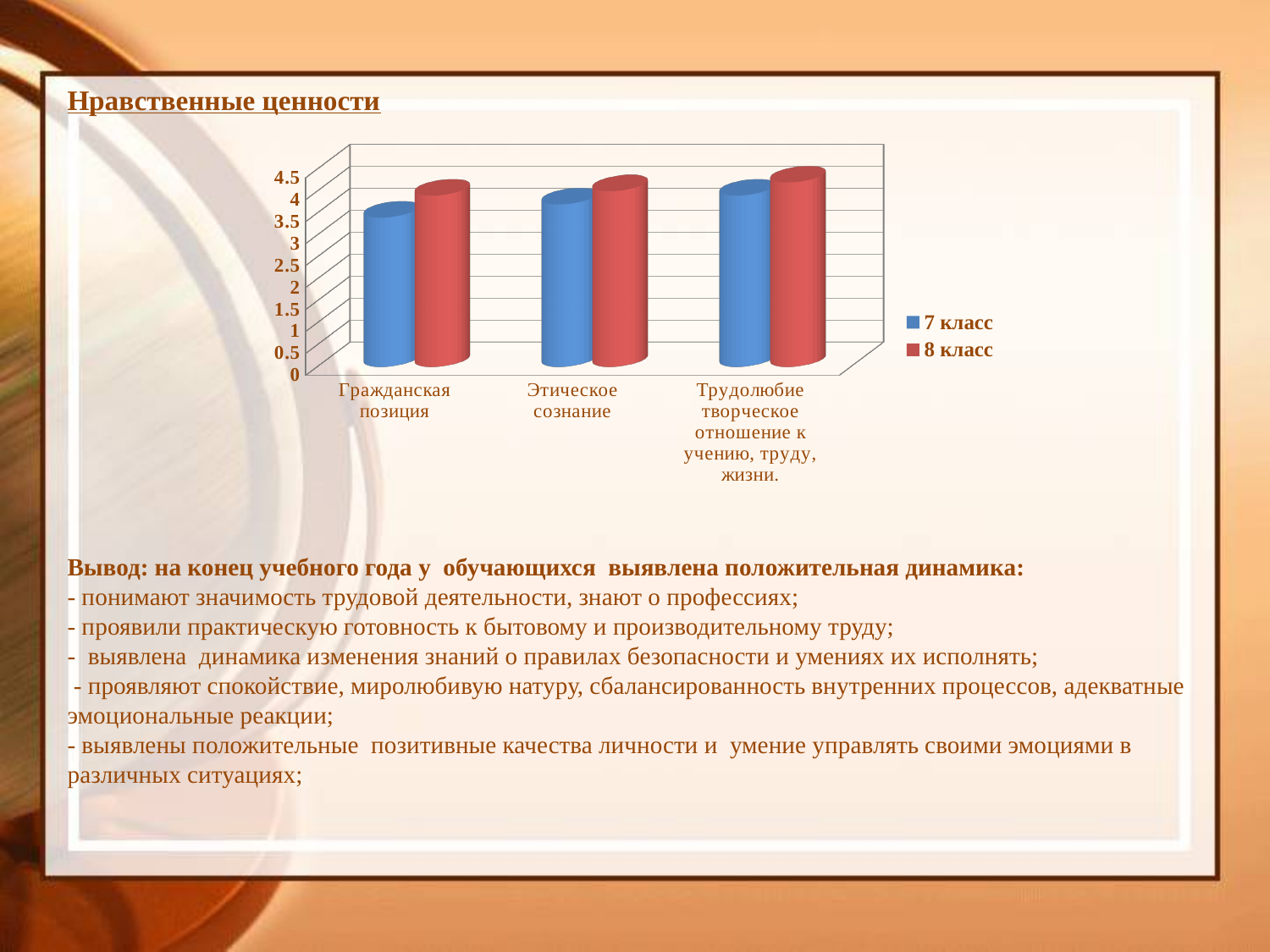
What colour are the bars for the 7 класс series? Blue Is the value for 7 класс in the category Гражданская позиция greater or less than 4? less What are the two series named in the chart legend? 7 класс and 8 класс What kind of chart is shown on the slide? Bar chart Do the values for the 7 класс series rise or fall from left to right along the x axis? Rise Which category has the lowest value for the 7 класс series? Гражданская позиция How many series does the chart legend list? 2 Is the value for 8 класс in the category Гражданская позиция greater or less than 3.5? greater In the category Гражданская позиция, which series has the larger value, 7 класс or 8 класс? 8 класс How many categories are shown on the x axis of the chart? 3 Is the value for 8 класс in the category Трудолюбие творческое отношение к учению, труду, жизни greater or less than 4? greater Which category has the highest value for the 8 класс series? Трудолюбие творческое отношение к учению, труду, жизни